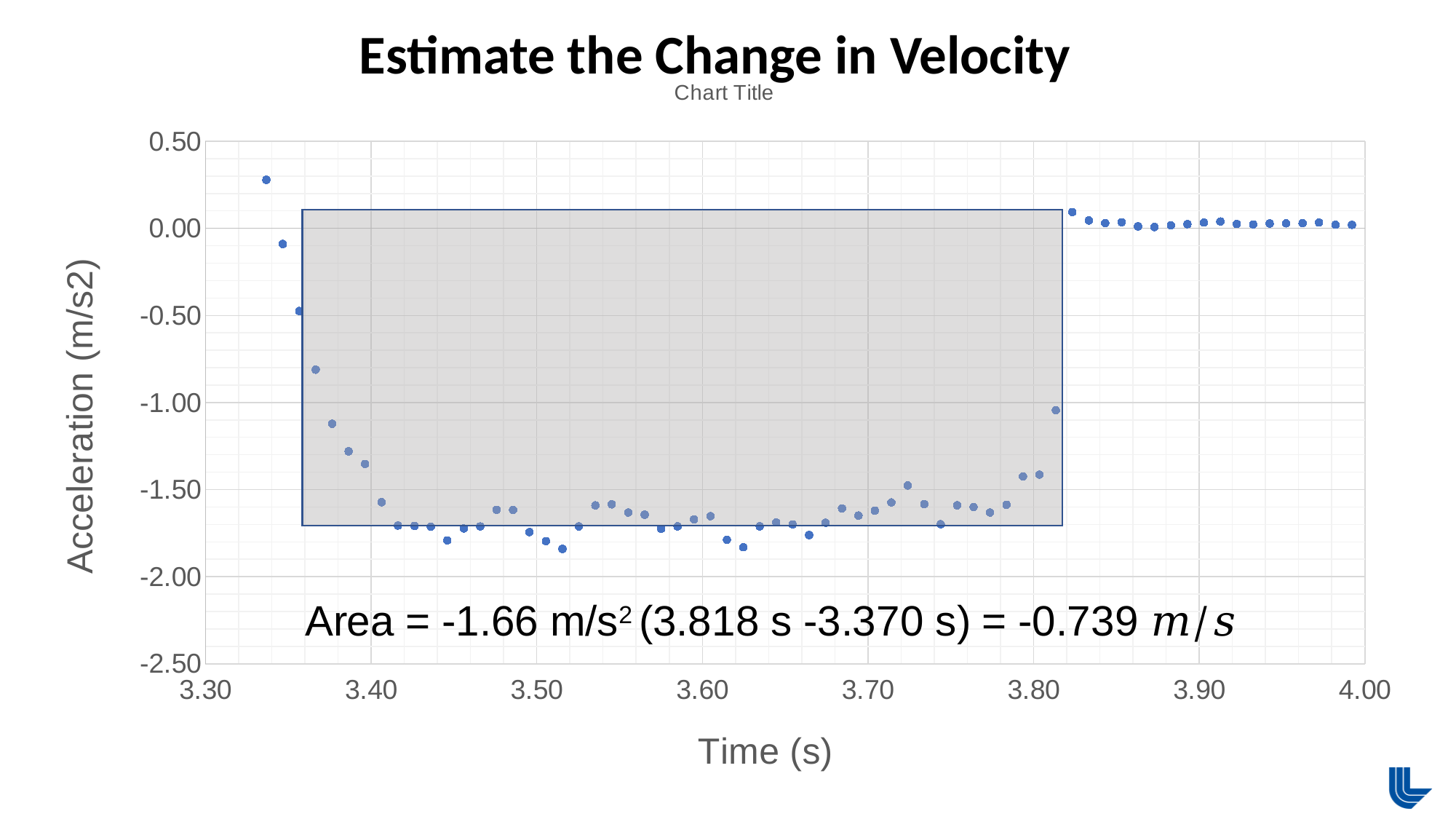
Is the acceleration value at about 3.90 s greater or less than -0.50? greater Do the acceleration values rise or fall as time goes from about 3.34 s to 3.42 s? fall What is the label of the y axis? Acceleration (m/s2) Is the acceleration value at about 3.50 s greater or less than -1.50? less Do the acceleration values rise or fall as time goes from about 3.70 s to 3.82 s? rise Which is larger, the acceleration at about 3.90 s or the acceleration at about 3.60 s? 3.90 s According to the annotation on the chart, what is the computed area (change in velocity)? -0.739 m/s Is the acceleration value at about 3.40 s greater or less than -1.00? less What kind of chart is shown on the slide? scatter chart